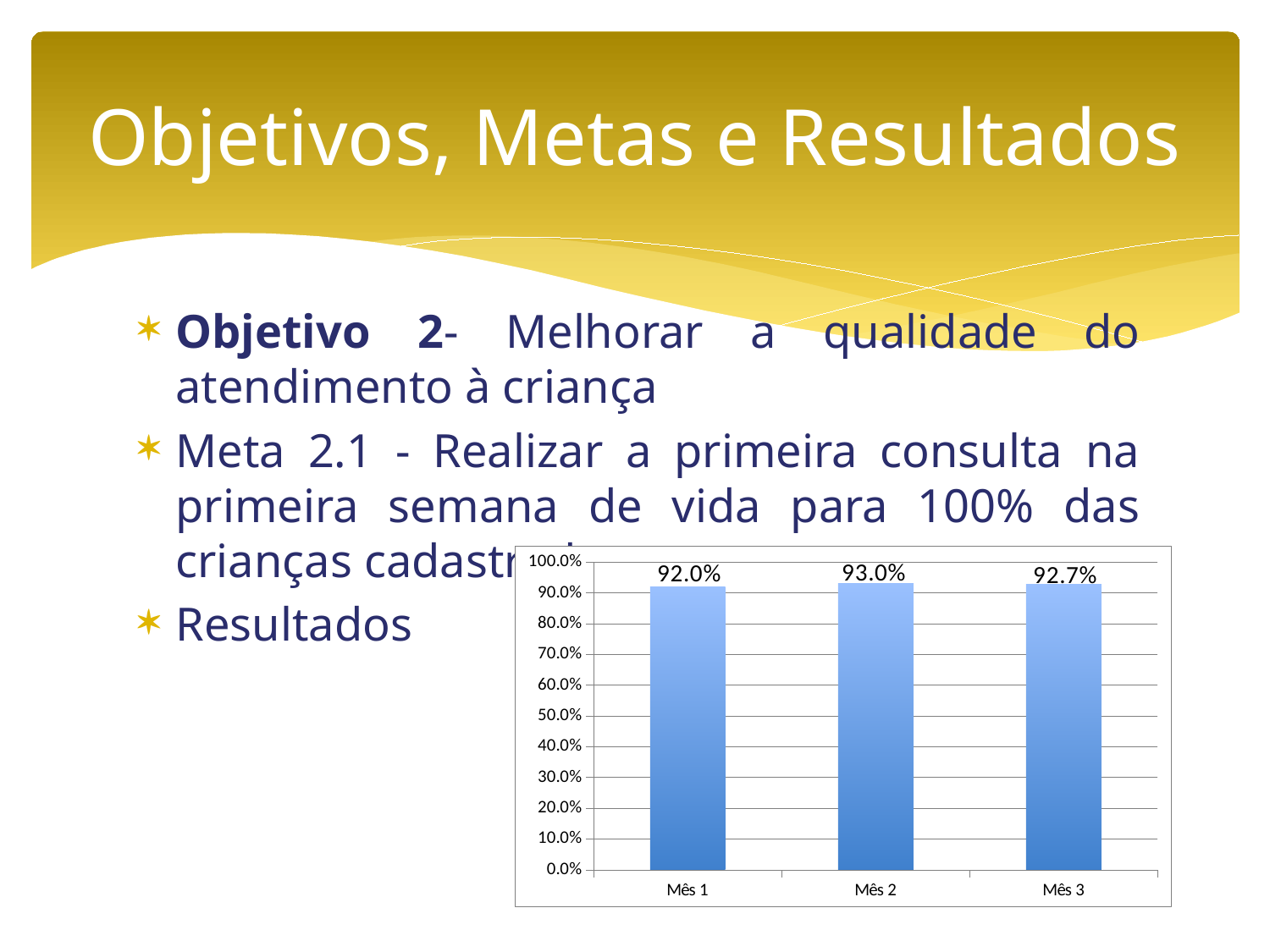
Which is larger, the value for Mês 3 or the value for Mês 1? Mês 3 What is the value for Mês 3? 92.7% What is the difference between the values for Mês 2 and Mês 3? 0.3% What kind of chart is shown on the slide? bar chart What is the value for Mês 1? 92.0% Is the value for Mês 1 greater or less than 90.0%? greater Which month has the lowest value? Mês 1 What is the difference between the values for Mês 2 and Mês 1? 1.0% What is the value for Mês 2? 93.0% Which month has the highest value? Mês 2 How many categories are shown on the x axis? 3 What is the highest tick value shown on the y axis? 100.0%